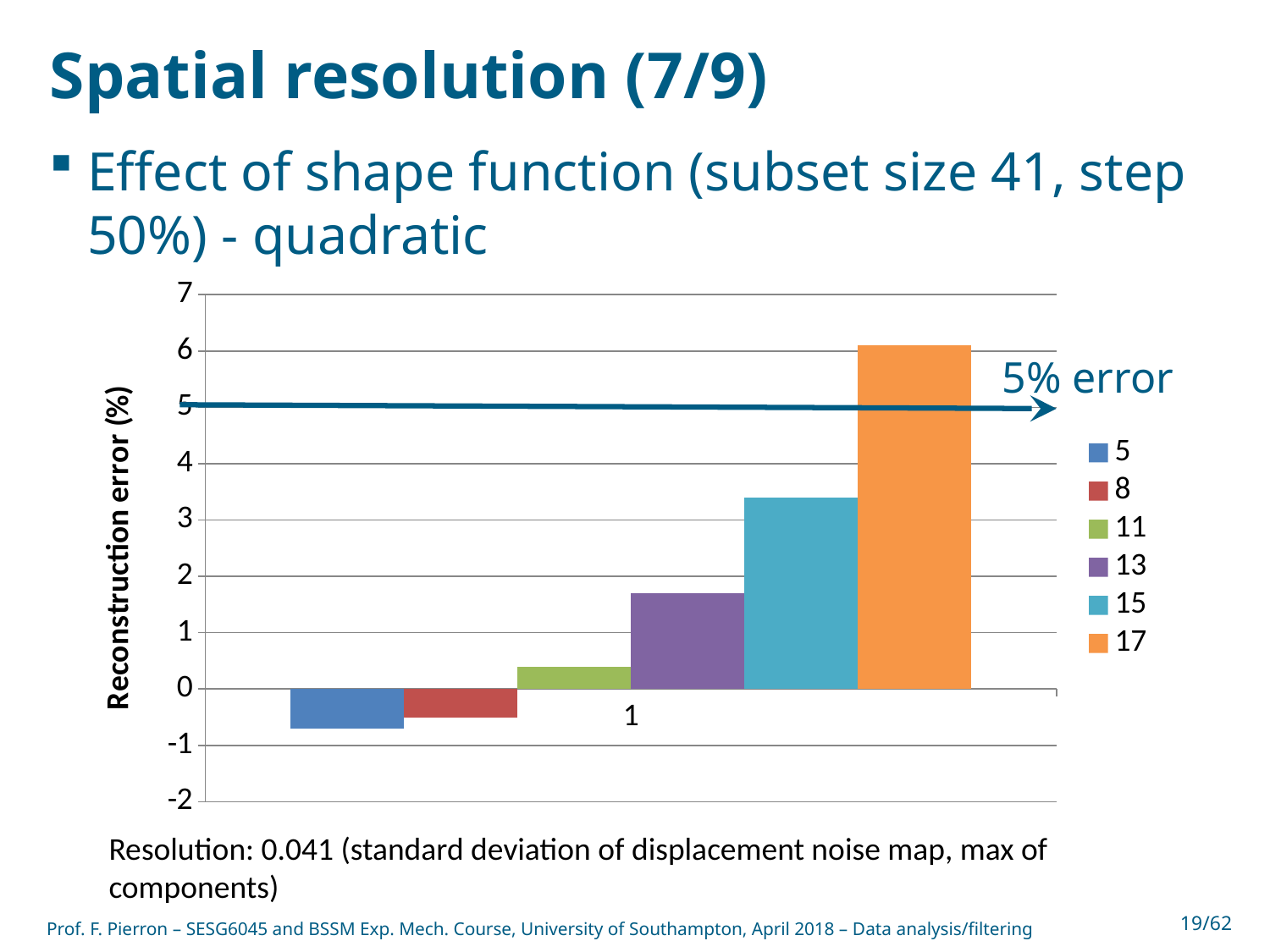
How many series does the legend list? 6 Is the reconstruction error for series 5 greater or less than 0? less Which series has the highest reconstruction error? 17 What is the title of the vertical axis? Reconstruction error (%) What kind of chart is shown on the slide? bar chart Is the reconstruction error for series 13 greater or less than 2? less Which series has the lowest reconstruction error? 5 How many categories are shown on the x axis? 1 Which series has a larger reconstruction error, 15 or 17? 17 Is the reconstruction error for series 15 greater or less than 3? greater Do the reconstruction error values rise or fall as the series go from 5 to 17? rise